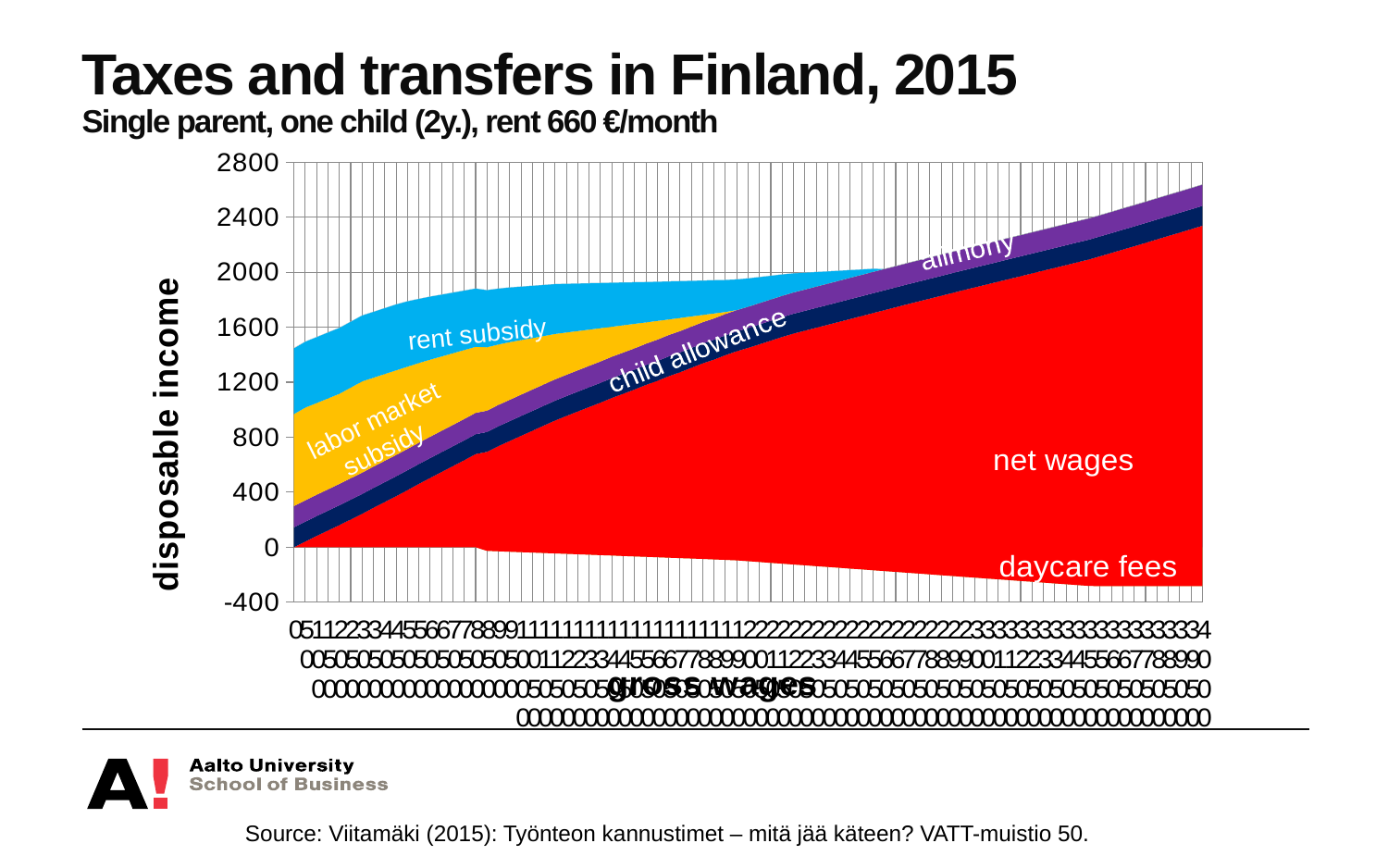
What is the label on the horizontal axis of the chart? gross wages What is the highest tick value shown on the vertical axis? 2800 How many labelled components (series) are shown in the stacked area chart? 6 Does the rent subsidy area grow or shrink as gross wages increase along the x axis? shrink Does the net wages area rise or fall as gross wages increase along the x axis? rise Is the total disposable income at the far right of the chart greater or less than 2400? greater What kind of chart is shown on the slide? stacked area chart What is the label on the vertical axis of the chart? disposable income Which component is plotted as the largest area at the right-hand side of the chart? net wages Which component is plotted as a negative value (below zero) in the chart? daycare fees Are the daycare fees plotted above or below 0 on the vertical axis? below Is the total disposable income at the far left of the chart (zero gross wages) greater or less than 1200? greater